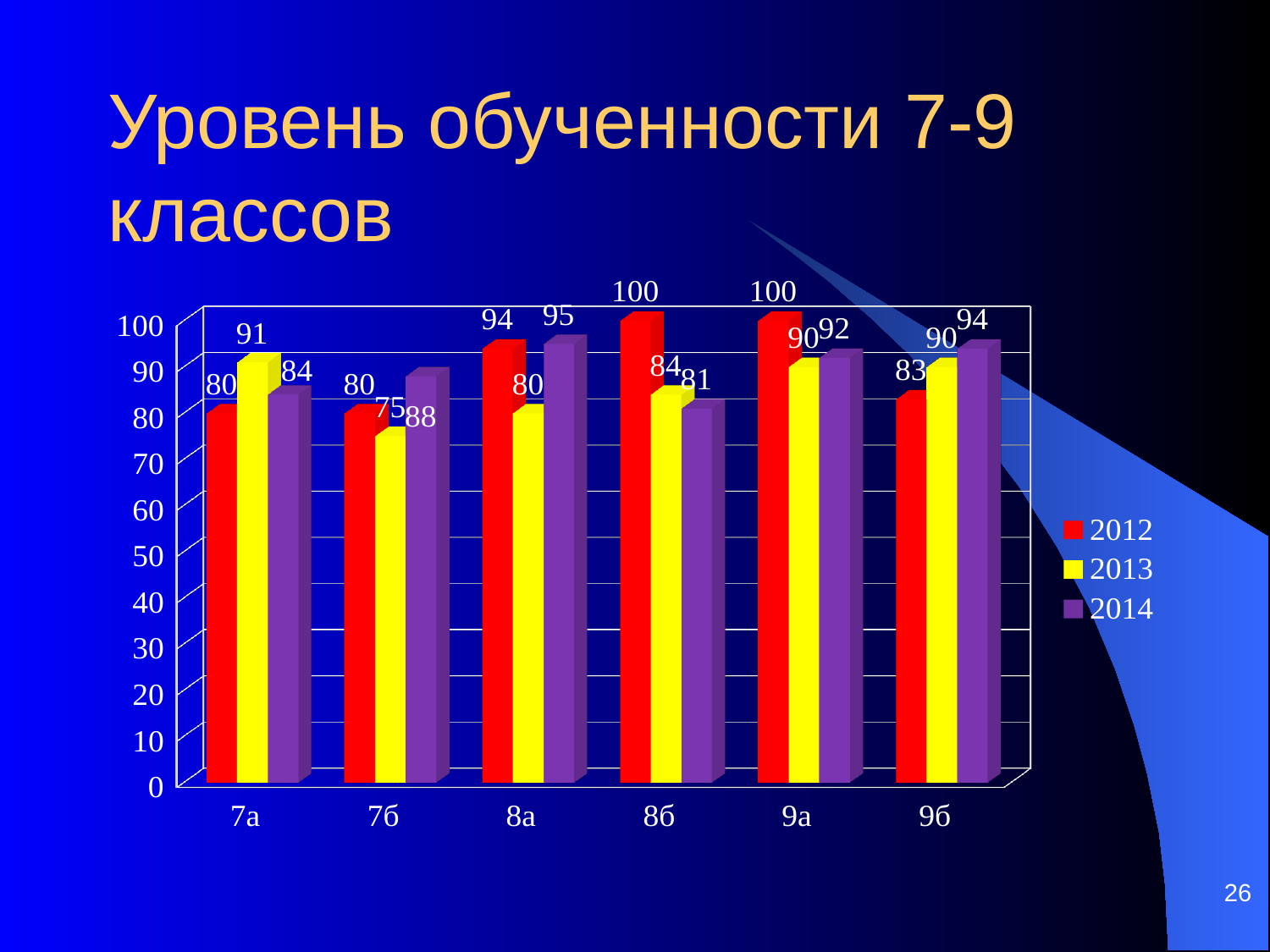
What is the value for 7б in the 2014 series? 88 Which category has the lowest value in the 2013 series? 7б Which is larger for 8а: the 2012 value or the 2013 value? 2012 What is the value for 9б in the 2013 series? 90 What is the value for 7а in the 2013 series? 91 Which colour represents the 2014 series in the legend? purple What kind of chart is shown on the slide? bar chart What is the value for 8б in the 2012 series? 100 How many categories are shown on the x axis? 6 How many series does the legend list? 3 Which category has the highest value in the 2014 series? 8а What is the difference between the 2014 and 2012 values for 9б? 11